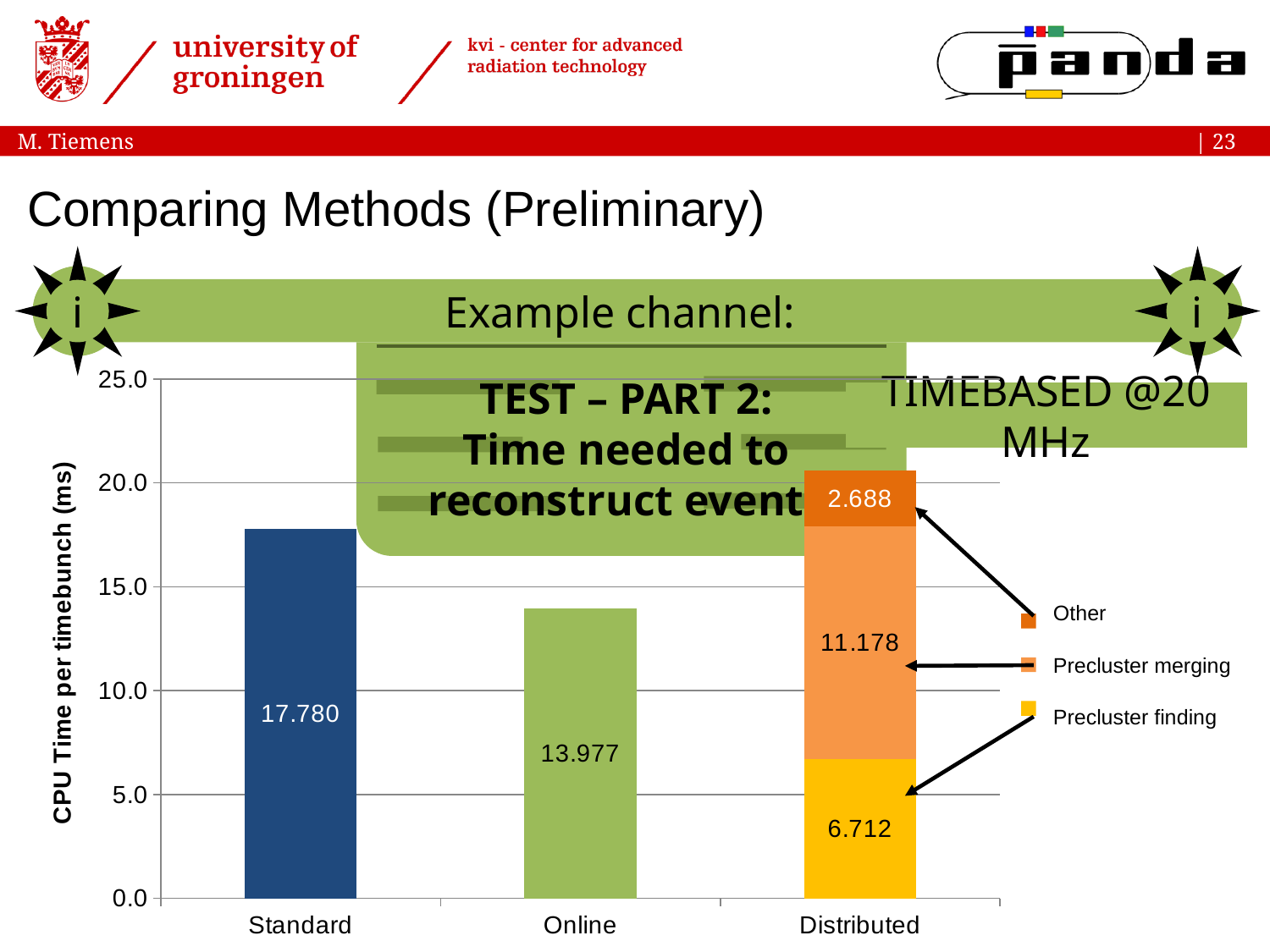
What is the Precluster merging value in the Distributed bar? 11.178 What is the total CPU time per timebunch for the Distributed bar? 20.578 Which method has the lowest CPU time per timebunch? Online What is the Other value in the Distributed bar? 2.688 What is the label of the y axis? CPU Time per timebunch (ms) What is the CPU time per timebunch for the Standard method? 17.780 What is the CPU time per timebunch for the Online method? 13.977 How many methods (categories) are shown on the x axis? 3 What is the Precluster finding value in the Distributed bar? 6.712 How many entries does the legend list? 3 What is the difference in CPU time between the Standard and Online methods? 3.803 Which is larger, the Standard bar or the Online bar? Standard